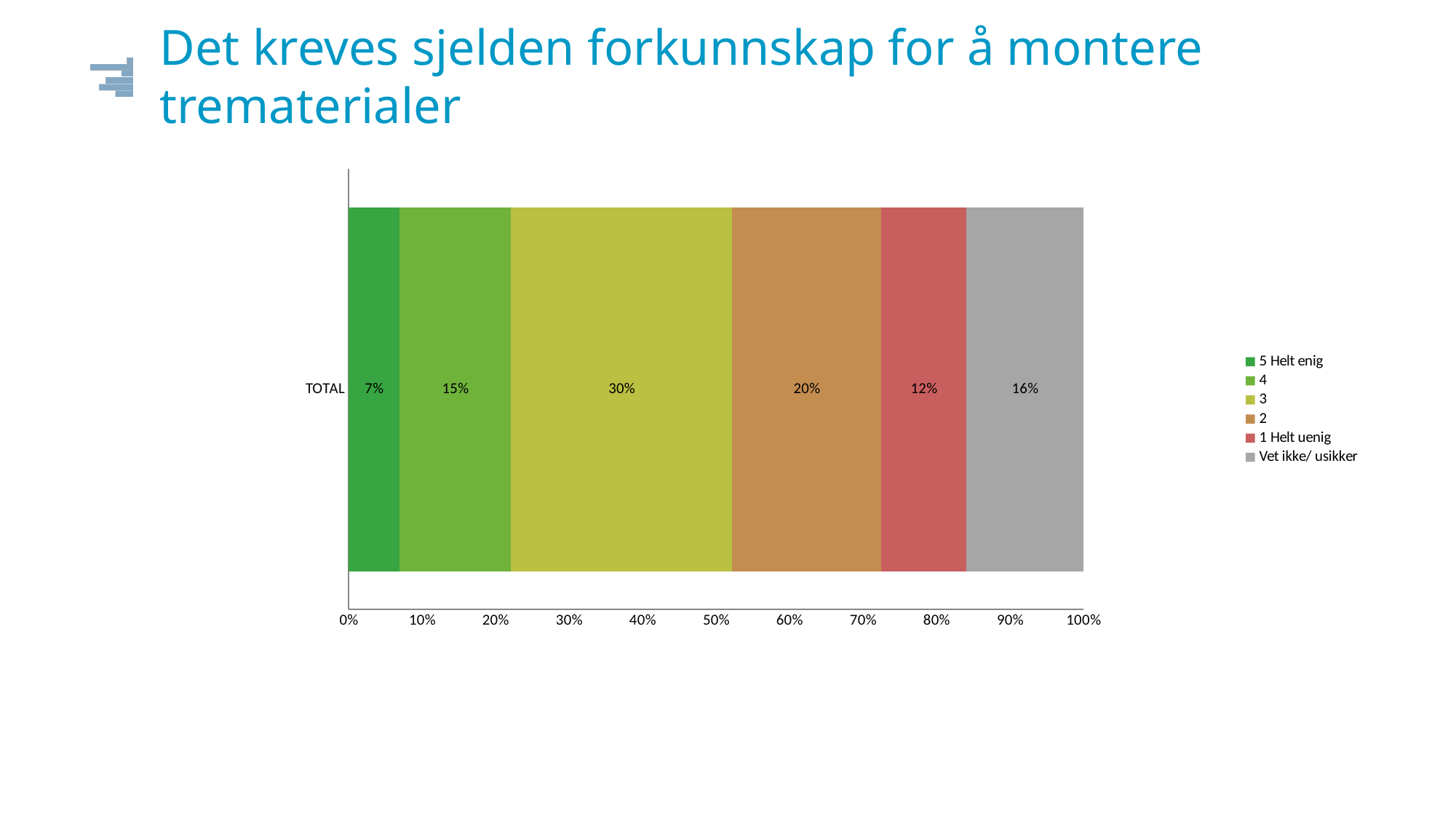
What is the difference between the '3' share and the '2' share in the TOTAL bar? 10% What percentage of the TOTAL bar is '3'? 30% What colour represents 'Vet ikke/ usikker' in the chart? Grey What percentage of the TOTAL bar is '1 Helt uenig'? 12% Which is larger in the TOTAL bar, '4' or '1 Helt uenig'? 4 What percentage of the TOTAL bar is '5 Helt enig'? 7% What percentage of the TOTAL bar is 'Vet ikke/ usikker'? 16% What is the combined share of '5 Helt enig' and '4' in the TOTAL bar? 22% What kind of chart is shown on the slide? Stacked bar chart How many series does the legend list? 6 Which series has the smallest share of the TOTAL bar? 5 Helt enig Which series has the largest share of the TOTAL bar? 3